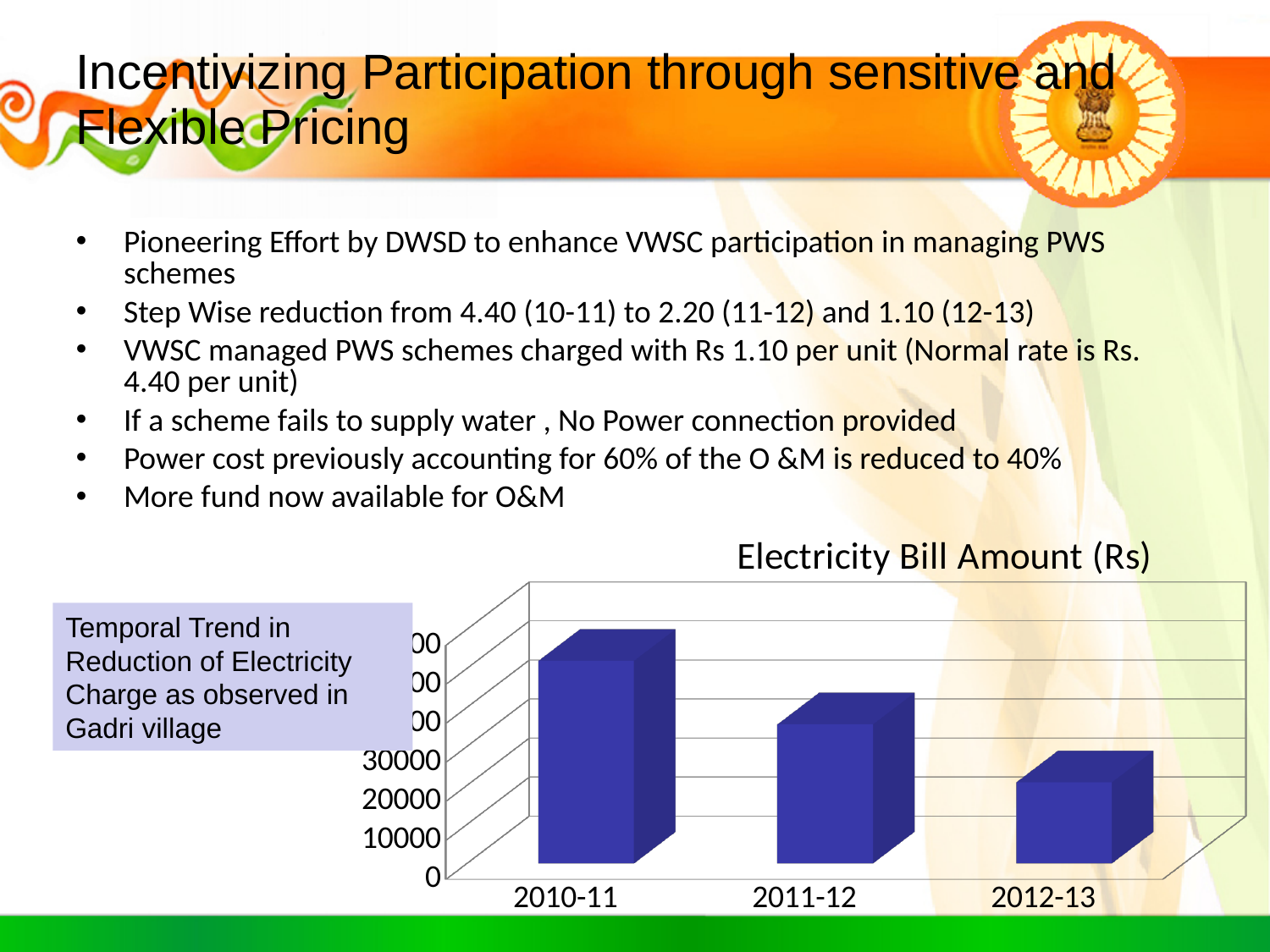
Which year has the highest electricity bill amount in the chart? 2010-11 What kind of chart is shown on the slide? bar chart Which is larger, the electricity bill amount for 2010-11 or for 2012-13? 2010-11 Which year has the lowest electricity bill amount in the chart? 2012-13 Is the electricity bill amount for 2011-12 greater or less than 30000? greater Do the electricity bill amounts rise or fall from 2010-11 to 2012-13? fall What is the title of the chart? Electricity Bill Amount (Rs) How many categories are plotted on the x axis of the chart? 3 What colour are the bars in the chart? blue Is the electricity bill amount for 2012-13 greater or less than 30000? less Which is larger, the electricity bill amount for 2011-12 or for 2012-13? 2011-12 Is the electricity bill amount for 2010-11 greater or less than 30000? greater